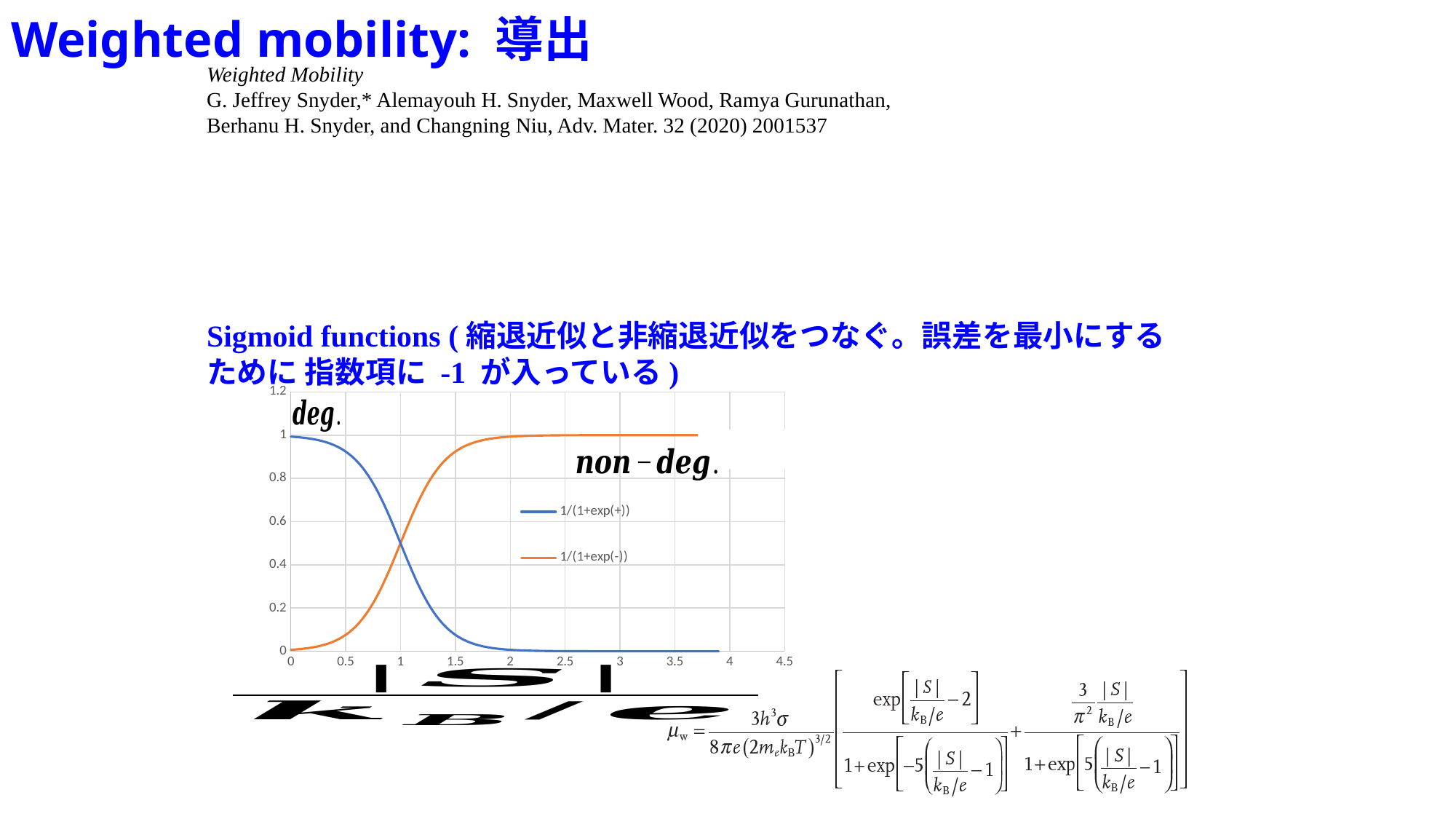
What is the highest tick value shown on the chart's x axis? 4.5 At x = 0.5, which series has the larger value, 1/(1+exp(+)) or 1/(1+exp(-))? 1/(1+exp(+)) What colour is the line for the series 1/(1+exp(-))? orange Is the value of the blue series 1/(1+exp(+)) at x = 2 greater or less than 0.2? less Is the value of the orange series 1/(1+exp(-)) at x = 2 greater or less than 0.8? greater How many series does the chart's legend list? 2 Is the value of the blue series 1/(1+exp(+)) at x = 0.5 greater or less than 0.8? greater What kind of chart is shown on the slide? line chart At x = 2, which series has the larger value, 1/(1+exp(+)) or 1/(1+exp(-))? 1/(1+exp(-)) Does the blue series 1/(1+exp(+)) rise or fall as the x value increases? fall Does the orange series 1/(1+exp(-)) rise or fall as the x value increases? rise